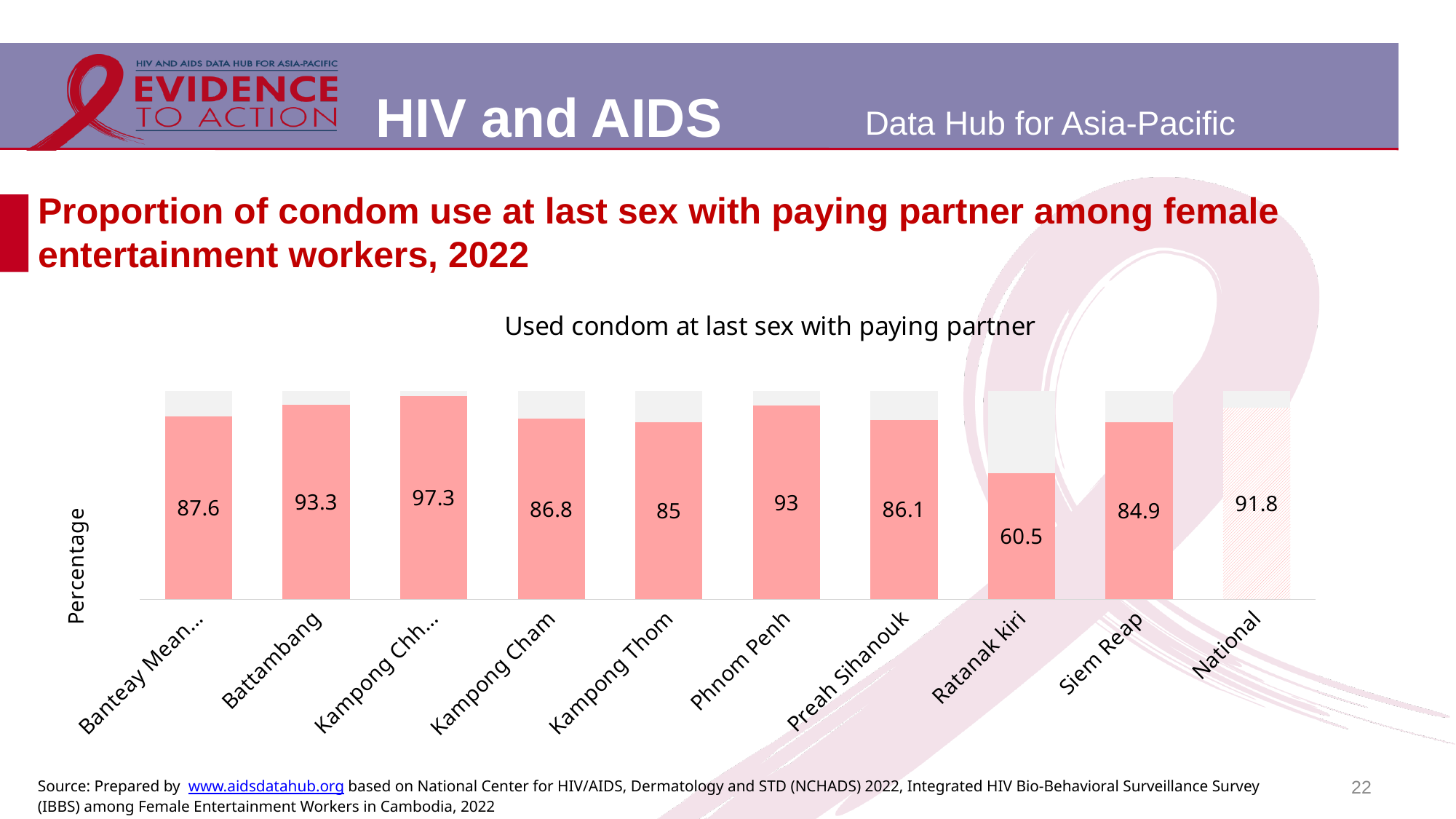
What kind of chart is shown on the slide? Bar chart What is the title of the chart? Used condom at last sex with paying partner Which is larger, the value for Kampong Cham or the value for Preah Sihanouk? Kampong Cham What is the value for Kampong Thom? 85 What is the difference between the values for Phnom Penh and Ratanak kiri? 32.5 What is the National value shown in the chart? 91.8 Which category has the lowest value? Ratanak kiri What is the value for Battambang? 93.3 What is the value for Ratanak kiri? 60.5 What is the value for Siem Reap? 84.9 What is the label on the vertical axis of the chart? Percentage How many bars are shown in the chart? 10